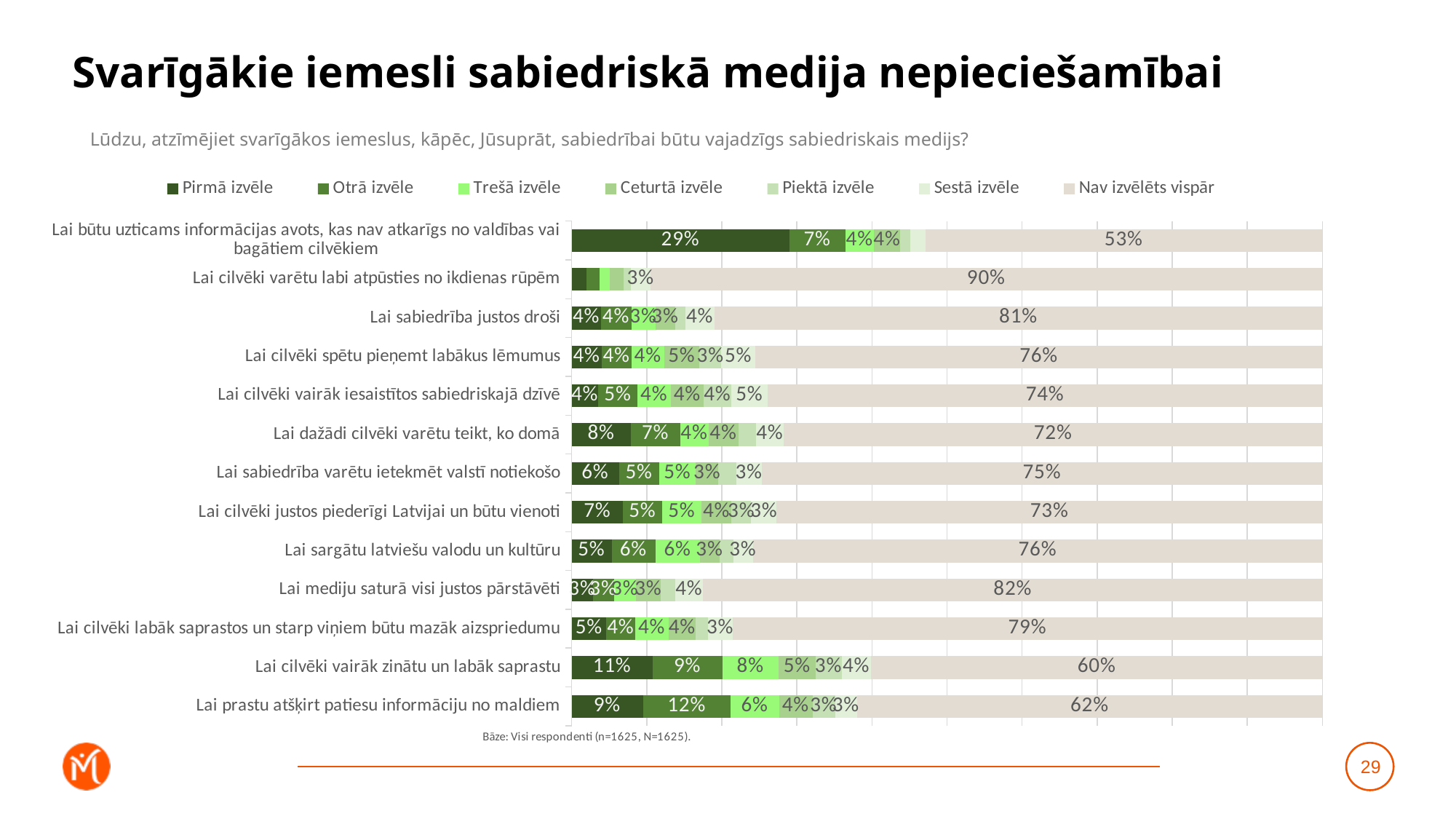
What is the difference in 'Nav izvēlēts vispār' between 'Lai prastu atšķirt patiesu informāciju no maldiem' and 'Lai cilvēki vairāk zinātu un labāk saprastu'? 2 percentage points What is the 'Pirmā izvēle' value for 'Lai būtu uzticams informācijas avots, kas nav atkarīgs no valdības vai bagātiem cilvēkiem'? 29% What is the 'Trešā izvēle' value for 'Lai cilvēki vairāk zinātu un labāk saprastu'? 8% How many series does the legend list? 7 What is the last entry in the chart's legend? Nav izvēlēts vispār Which has the larger 'Otrā izvēle' value: 'Lai prastu atšķirt patiesu informāciju no maldiem' or 'Lai cilvēki vairāk zinātu un labāk saprastu'? Lai prastu atšķirt patiesu informāciju no maldiem What kind of chart is shown on the slide? Stacked bar chart Which category has the lowest 'Nav izvēlēts vispār' value? Lai būtu uzticams informācijas avots, kas nav atkarīgs no valdības vai bagātiem cilvēkiem What is the 'Otrā izvēle' value for 'Lai dažādi cilvēki varētu teikt, ko domā'? 7% What is the 'Nav izvēlēts vispār' value for 'Lai cilvēki varētu labi atpūsties no ikdienas rūpēm'? 90% How many categories (reasons) are plotted in the chart? 13 Which category has the highest 'Nav izvēlēts vispār' value? Lai cilvēki varētu labi atpūsties no ikdienas rūpēm